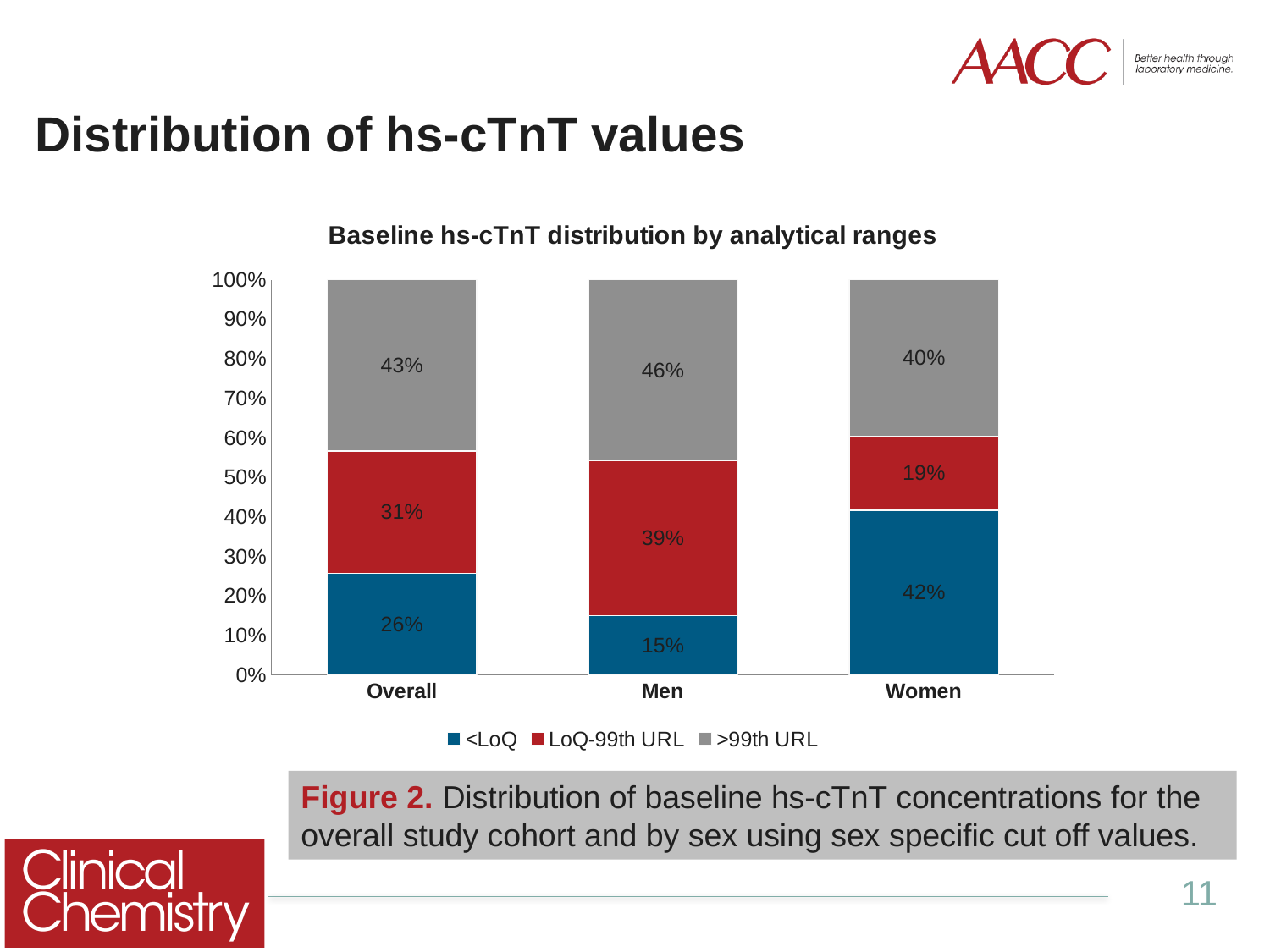
How many series does the legend list? 3 Which colour represents the >99th URL series? Grey What is the title of the chart? Baseline hs-cTnT distribution by analytical ranges Which category has the lowest value for >99th URL? Women What kind of chart is shown? Stacked bar chart What is the value for <LoQ in the Women category? 42% Which category has the highest value for <LoQ? Women Which is larger, the <LoQ value for Overall or the <LoQ value for Men? Overall What is the value for >99th URL in the Overall category? 43% What is the value for LoQ-99th URL in the Men category? 39% What is the difference between the LoQ-99th URL values for Men and Women? 20% How many categories are shown on the x axis? 3